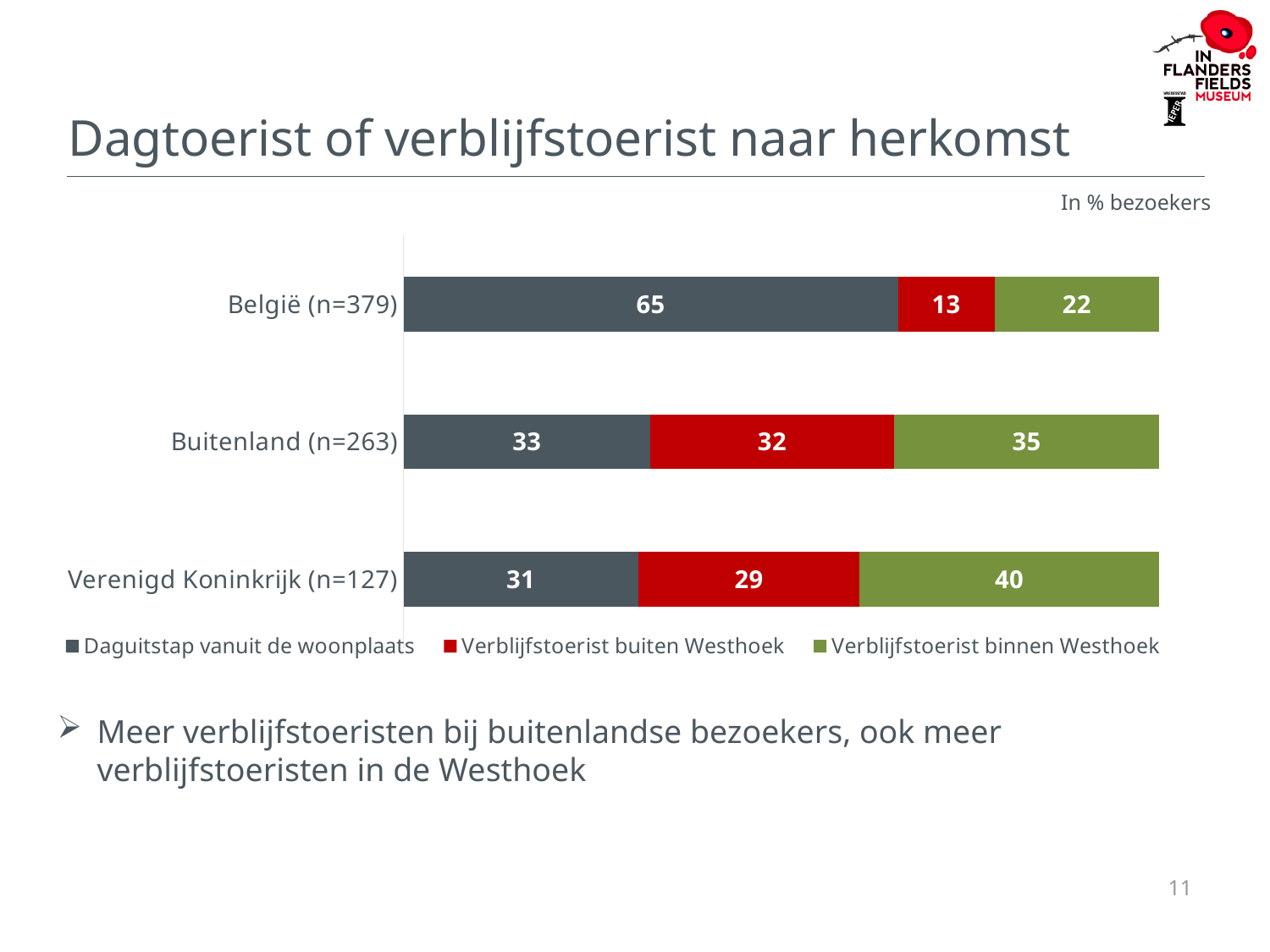
Which category has the highest value for 'Daguitstap vanuit de woonplaats'? België (n=379) What is the total of the stacked bar for Verenigd Koninkrijk (n=127)? 100 What is the difference between the 'Daguitstap vanuit de woonplaats' values for België (n=379) and Buitenland (n=263)? 32 What kind of chart is shown on the slide? Stacked bar chart What is the title of the chart on the slide? Dagtoerist of verblijfstoerist naar herkomst How many categories are shown on the chart? 3 Which category has the lowest value for 'Verblijfstoerist binnen Westhoek'? België (n=379) What is the value for 'Verblijfstoerist binnen Westhoek' for Verenigd Koninkrijk (n=127)? 40 What is the value for 'Verblijfstoerist buiten Westhoek' for Buitenland (n=263)? 32 How many series does the legend list? 3 Which is larger: 'Verblijfstoerist buiten Westhoek' for Buitenland (n=263) or for België (n=379)? Buitenland (n=263) What is the value for 'Daguitstap vanuit de woonplaats' for België (n=379)? 65